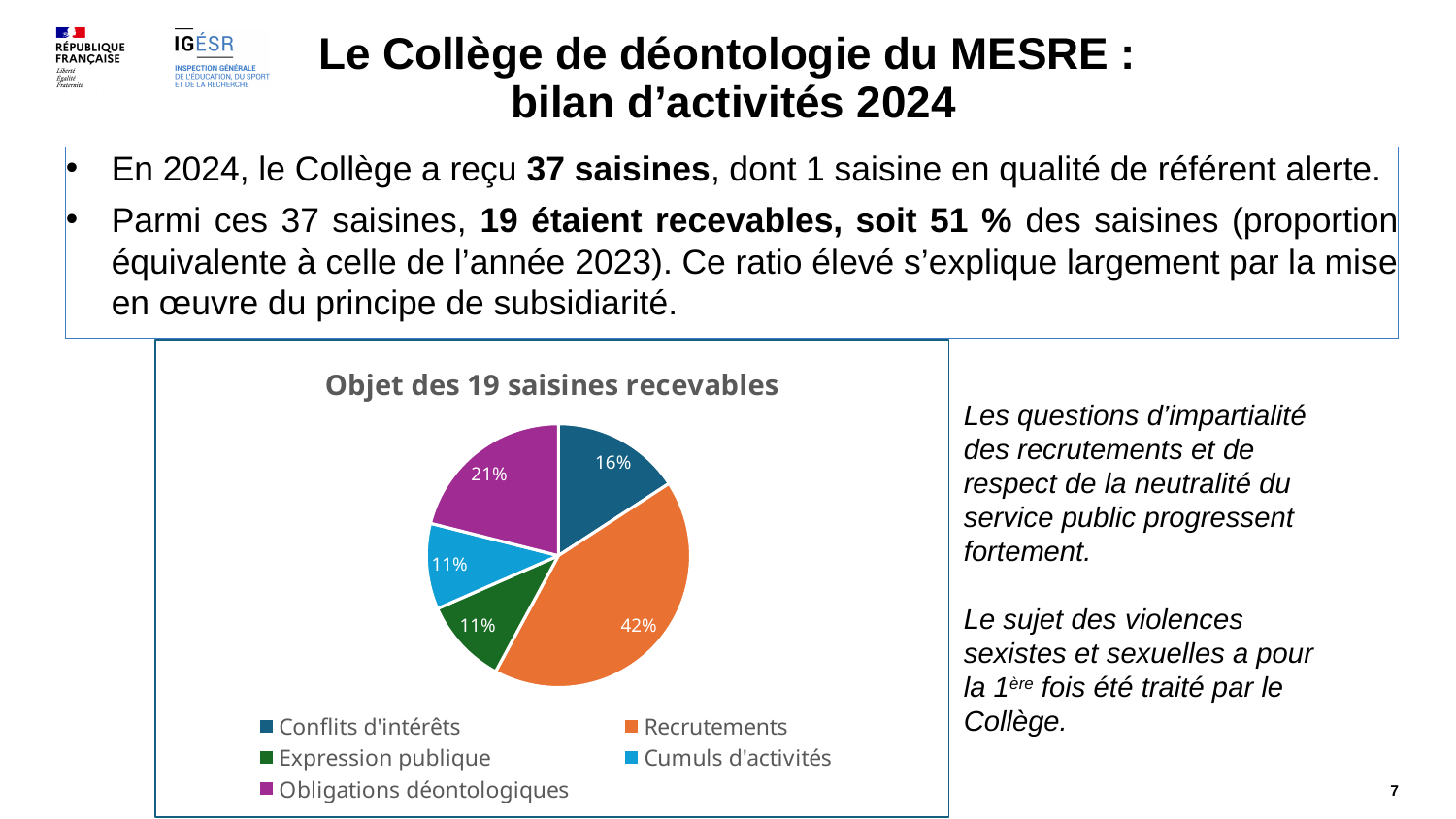
What is the title of the chart? Objet des 19 saisines recevables How many categories does the legend of the pie chart list? 5 What share of the pie does Expression publique represent? 11% What share of the pie does Cumuls d'activités represent? 11% Which is larger, the slice for Obligations déontologiques or the slice for Conflits d'intérêts? Obligations déontologiques What share of the pie does Obligations déontologiques represent? 21% Which category has the largest slice of the pie? Recrutements Which colour represents Recrutements in the pie chart? orange What type of chart is shown on the slide? pie chart What is the difference in percentage points between the Recrutements slice and the Obligations déontologiques slice? 21